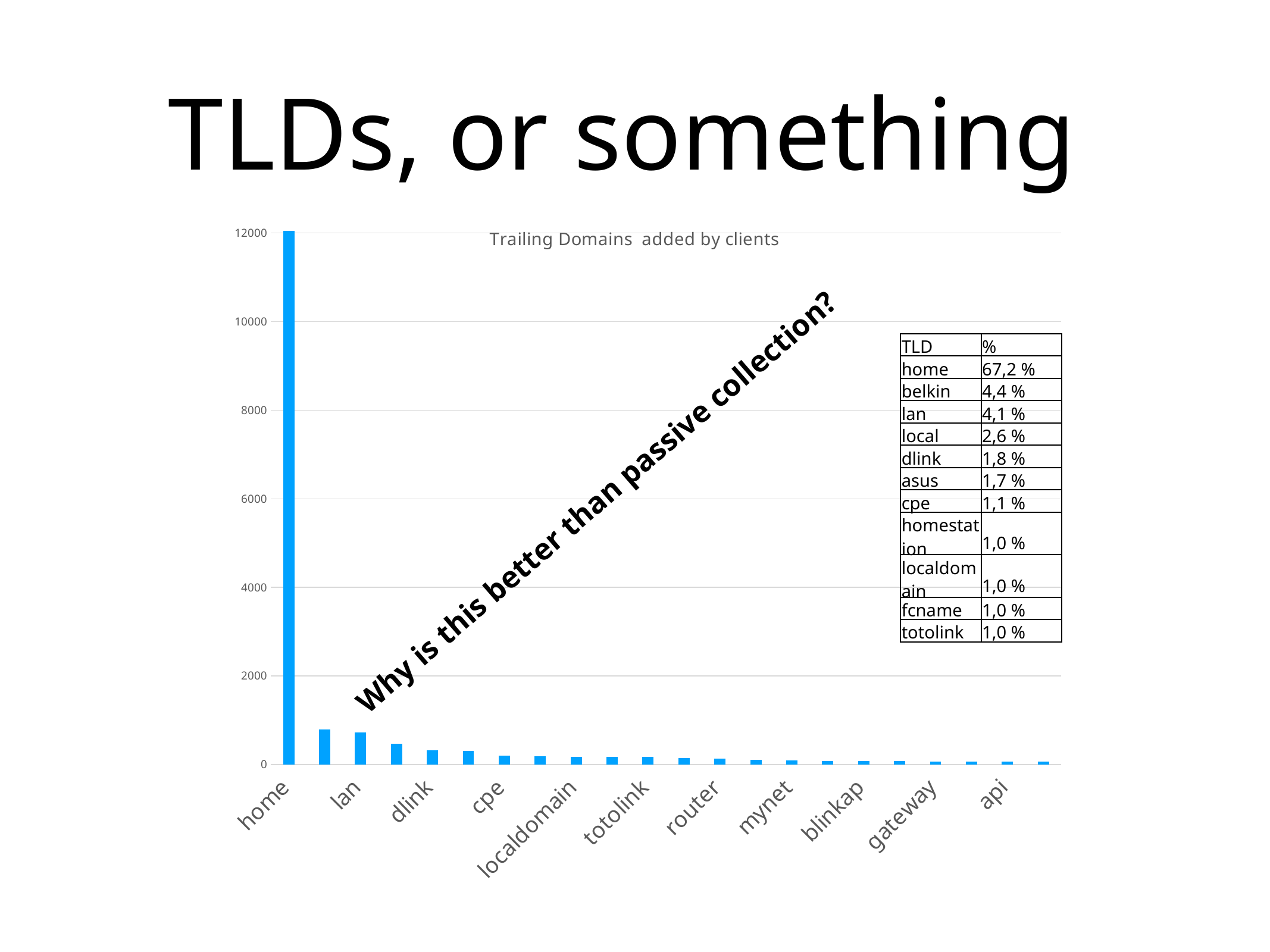
Which category has the highest bar in the chart? home Is the value for home greater or less than 8000? greater Is the value for lan greater or less than 2000? less Is the value for home greater or less than 10000? greater What is the first category label on the x axis? home What kind of chart is shown on the slide? bar chart What is the title of the chart? Trailing Domains added by clients Which is larger, the value for home or the value for lan? home Which is larger, the value for lan or the value for dlink? lan Do the bar values rise or fall moving from left to right along the x axis? fall